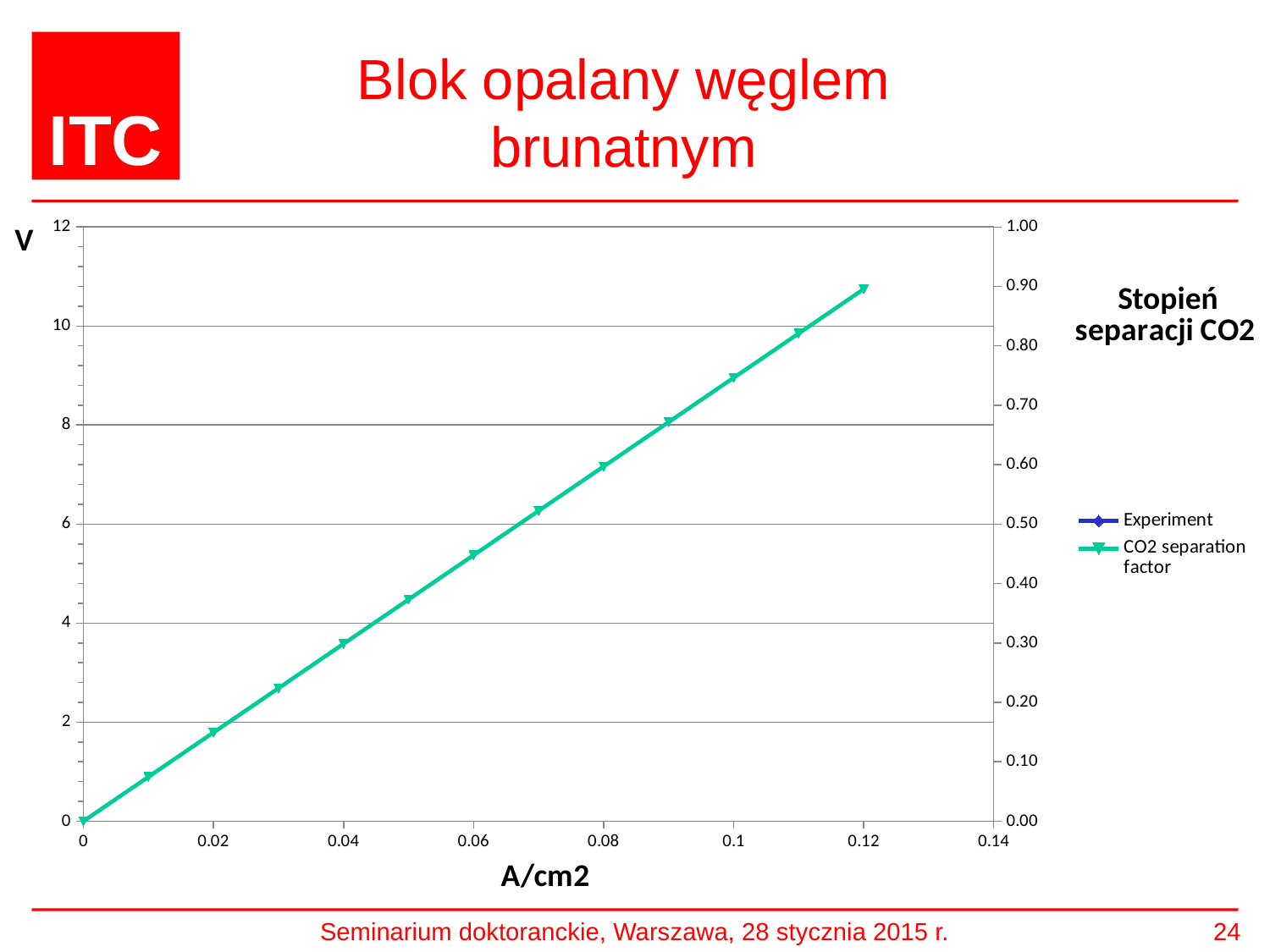
Is the CO2 separation factor at 0.06 A/cm2 greater or less than 0.50 on the right axis? less Does the CO2 separation factor rise or fall as the current density (A/cm2) increases? rise Is the CO2 separation factor at 0.12 A/cm2 greater or less than 0.80 on the right axis? greater How many data points are plotted on the CO2 separation factor line? 13 At which x value (A/cm2) is the CO2 separation factor lowest? 0 What kind of chart is shown on the slide? line chart What is the label of the x axis? A/cm2 How many series does the legend list? 2 What are the two series named in the legend? Experiment and CO2 separation factor At which x value (A/cm2) is the CO2 separation factor highest? 0.12 Is the CO2 separation factor at 0.10 A/cm2 greater or less than 0.70 on the right axis? greater What is the CO2 separation factor at 0 A/cm2, read on the right axis? 0.00